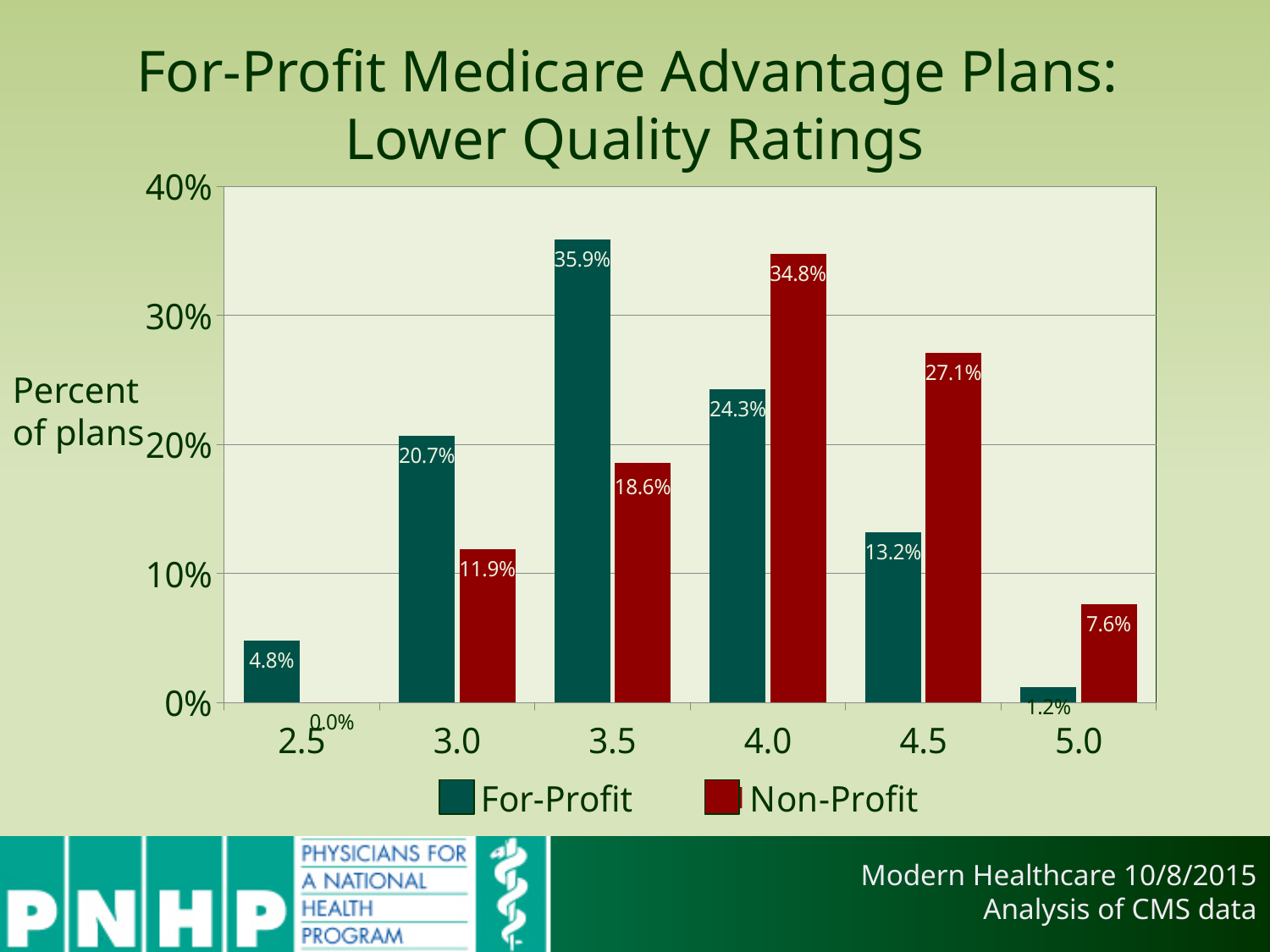
At the 5.0 rating, which series has the larger value, For-Profit or Non-Profit? Non-Profit At the 3.0 rating, which series has the larger value, For-Profit or Non-Profit? For-Profit What is the label on the y axis of the chart? Percent of plans Which rating category has the lowest value for Non-Profit plans? 2.5 How many series does the legend list? 2 How many rating categories are shown on the x axis? 6 What is the difference between the Non-Profit and For-Profit values at the 4.5 rating? 13.9% What kind of chart is shown on the slide? Bar chart What percent of Non-Profit plans have a 4.0 rating? 34.8% What is the value for Non-Profit plans at the 2.5 rating? 0.0% Which rating category has the highest value for For-Profit plans? 3.5 What percent of For-Profit plans have a 3.5 rating? 35.9%